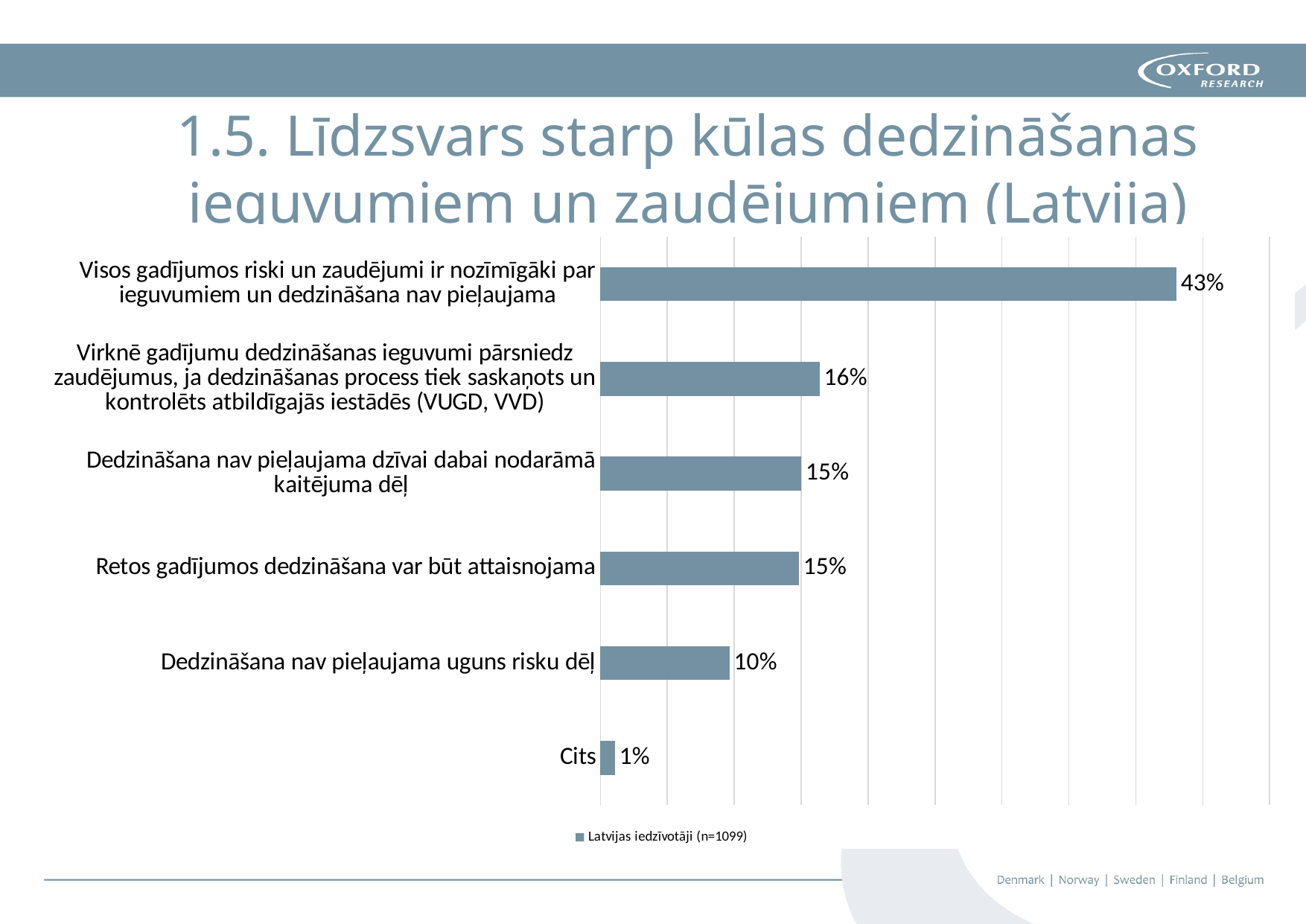
What percentage is shown for "Visos gadījumos riski un zaudējumi ir nozīmīgāki par ieguvumiem un dedzināšana nav pieļaujama"? 43% What kind of chart is shown on the slide? Bar chart How many categories are shown in the chart? 6 How many series does the legend list? 1 Which category has the highest percentage? Visos gadījumos riski un zaudējumi ir nozīmīgāki par ieguvumiem un dedzināšana nav pieļaujama What is the legend entry of the chart? Latvijas iedzīvotāji (n=1099) What percentage is shown for "Cits"? 1% Which is larger: the value for "Dedzināšana nav pieļaujama uguns risku dēļ" or the value for "Dedzināšana nav pieļaujama dzīvai dabai nodarāmā kaitējuma dēļ"? Dedzināšana nav pieļaujama dzīvai dabai nodarāmā kaitējuma dēļ What percentage is shown for "Dedzināšana nav pieļaujama uguns risku dēļ"? 10% Which category has the lowest percentage? Cits What percentage is shown for "Retos gadījumos dedzināšana var būt attaisnojama"? 15% What is the difference between the percentage for "Visos gadījumos riski un zaudējumi ir nozīmīgāki par ieguvumiem un dedzināšana nav pieļaujama" and "Dedzināšana nav pieļaujama uguns risku dēļ"? 33%